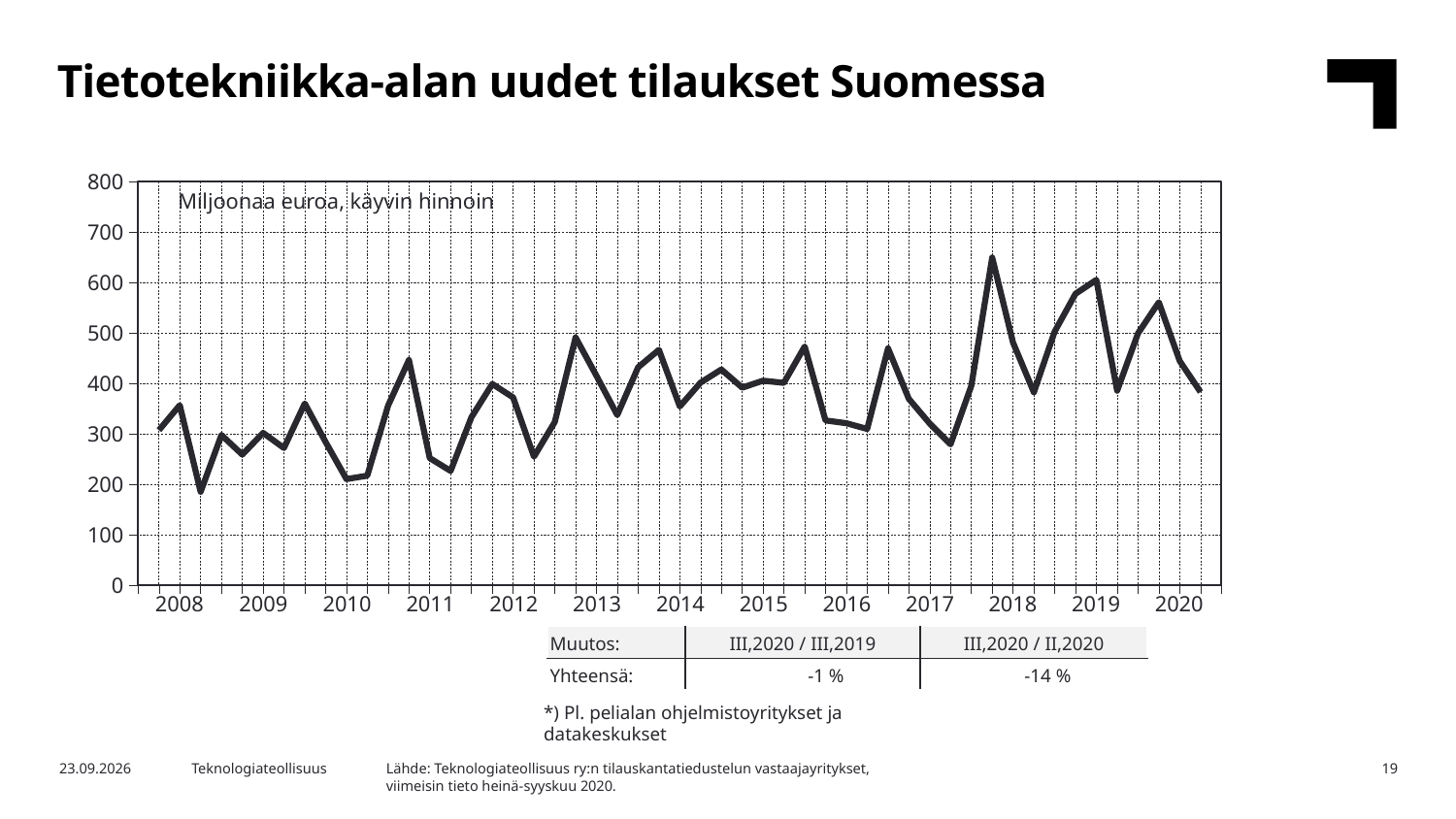
In what unit are the values on the chart expressed, according to the label inside the plot area? Miljoonaa euroa, käyvin hinnoin Is the first plotted value (2008) greater or less than 400? less According to the table below the chart, what is the change (Muutos) for III,2020 / III,2019? -1 % According to the table below the chart, what is the change (Muutos) for III,2020 / II,2020? -14 % Do the values rise or fall from the peak near 2019 to the end of the series in 2020? fall Is the lowest value on the line greater or less than 200? less What kind of chart is shown on the slide? line chart Is the highest value on the line greater or less than 600? greater How many year labels are shown on the x axis? 13 Do the values rise or fall from 2017 to the peak near 2018? rise What is the title of the chart? Tietotekniikka-alan uudet tilaukset Suomessa